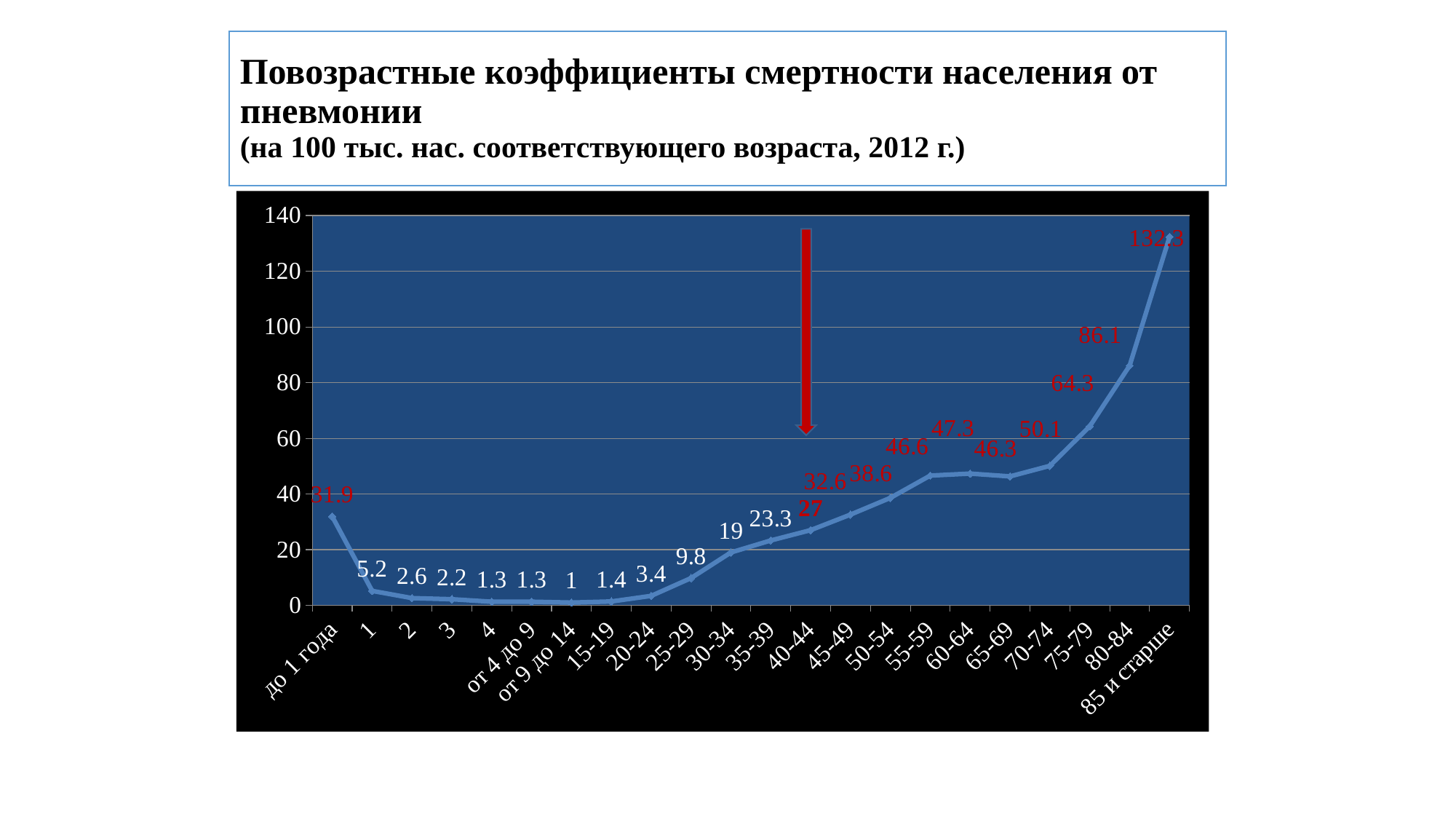
What is the difference between the values for 85 и старше and 80-84? 46.2 Which age group has a higher value, 55-59 or 70-74? 70-74 What is the pneumonia mortality rate for the age group 85 и старше? 132.3 Which age group has the lowest mortality rate? от 9 до 14 What is the difference between the values for до 1 года and 1? 26.7 Which age group has the highest mortality rate? 85 и старше Do the values rise or fall along the x axis from 25-29 to 85 и старше? Rise What is the value for the age group до 1 года? 31.9 What is the value for the age group 60-64? 47.3 What is the value for the age group 40-44? 27 How many age groups are plotted on the x axis? 22 What type of chart is shown on the slide? Line chart